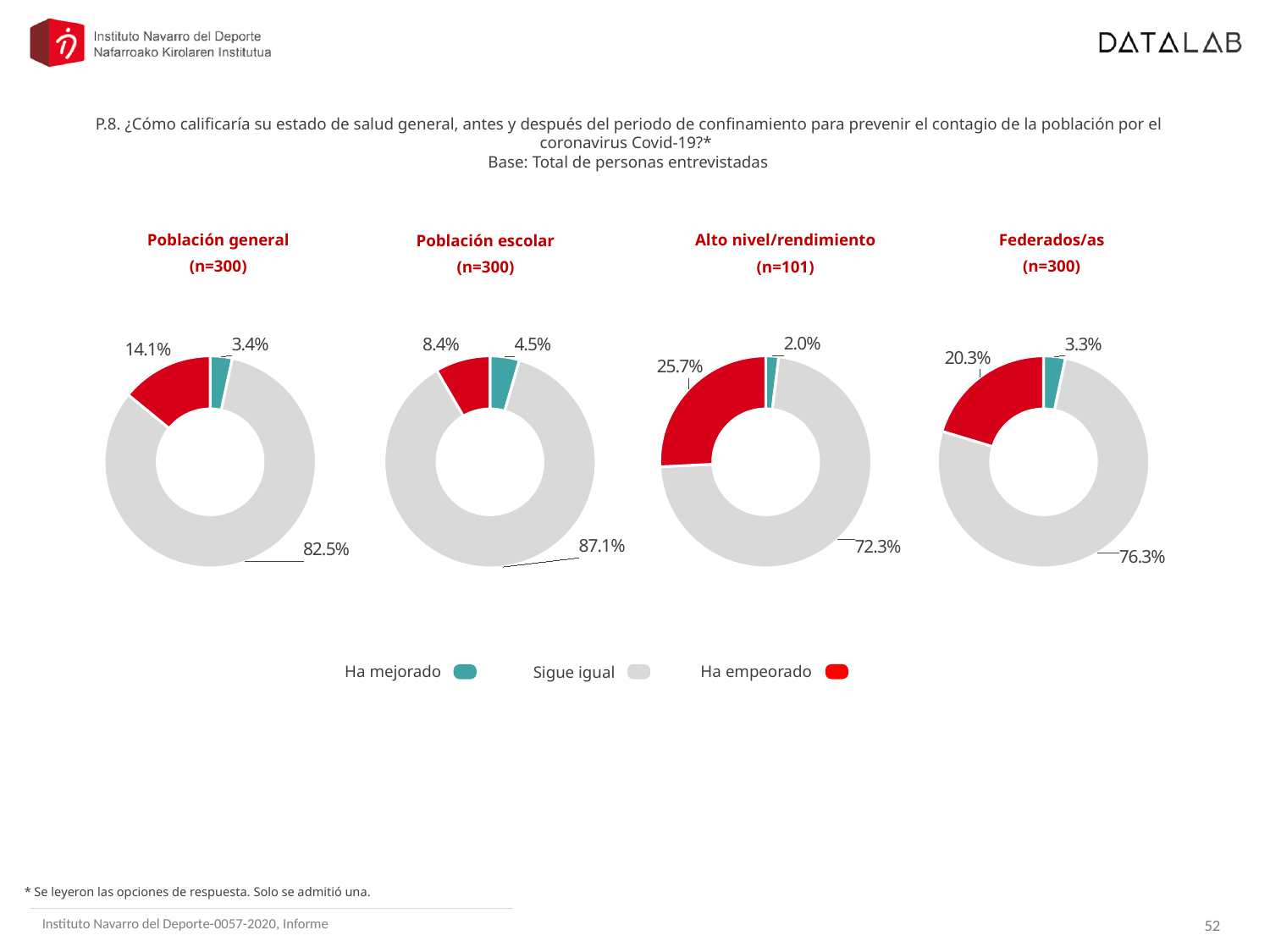
What type of chart is used on this slide? Donut (pie) chart In the 'Alto nivel/rendimiento' chart, which category has the largest share? Sigue igual How many donut charts are shown on the slide? 4 In the 'Federados/as' chart, what percentage corresponds to 'Ha empeorado'? 20.3% What is the difference between the 'Ha empeorado' share in the 'Alto nivel/rendimiento' chart and the 'Ha empeorado' share in the 'Población escolar' chart? 17.3% What is the sample size (n) shown for the 'Alto nivel/rendimiento' chart? n=101 In the 'Población general' chart, what percentage corresponds to 'Ha empeorado'? 14.1% Which chart shows a larger 'Ha mejorado' share: 'Población escolar' or 'Federados/as'? Población escolar In the 'Población general' chart, which category has the smallest share? Ha mejorado In the 'Alto nivel/rendimiento' chart, what percentage corresponds to 'Ha mejorado'? 2.0% How many categories does the legend list? 3 In the 'Población escolar' chart, what percentage corresponds to 'Sigue igual'? 87.1%